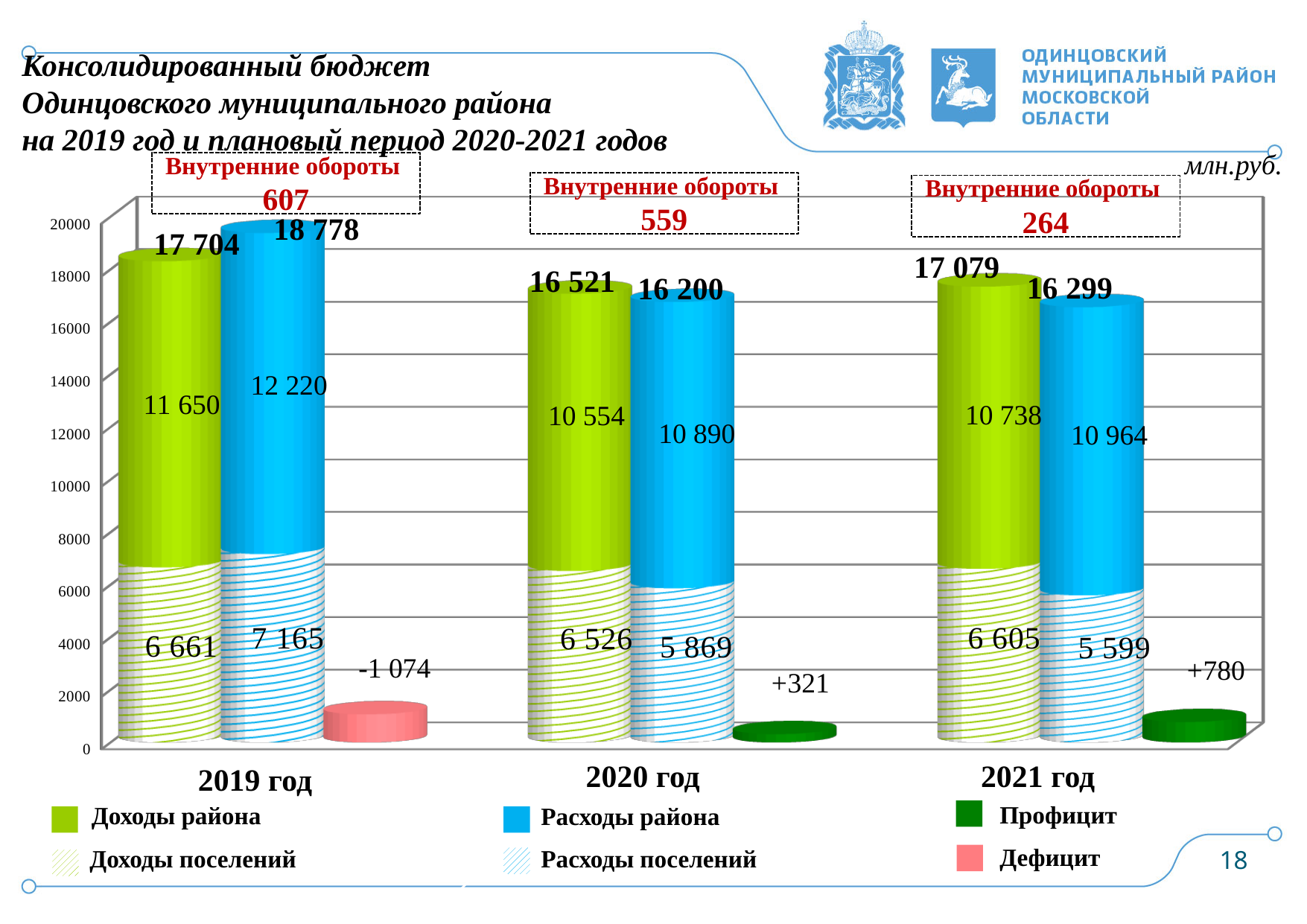
What is the value of Доходы района for 2019 год? 11 650 What total is printed above the income (Доходы) bar for 2020 год? 16 521 What is the difference between the total expenses (18 778) and total income (17 704) for 2019 год? 1 074 What value is shown for Профицит in 2021 год? +780 What value is shown for Дефицит in 2019 год? -1 074 Do the values of Расходы поселений rise or fall from 2019 год to 2021 год? fall How many entries does the legend list? 6 What is the value of Внутренние обороты shown for 2020 год? 559 In 2020 год, which is larger: Доходы района or Расходы района? Расходы района What is the value of Расходы поселений for 2021 год? 5 599 In which year is Расходы района the highest? 2019 год In which year is Доходы поселений the lowest? 2020 год